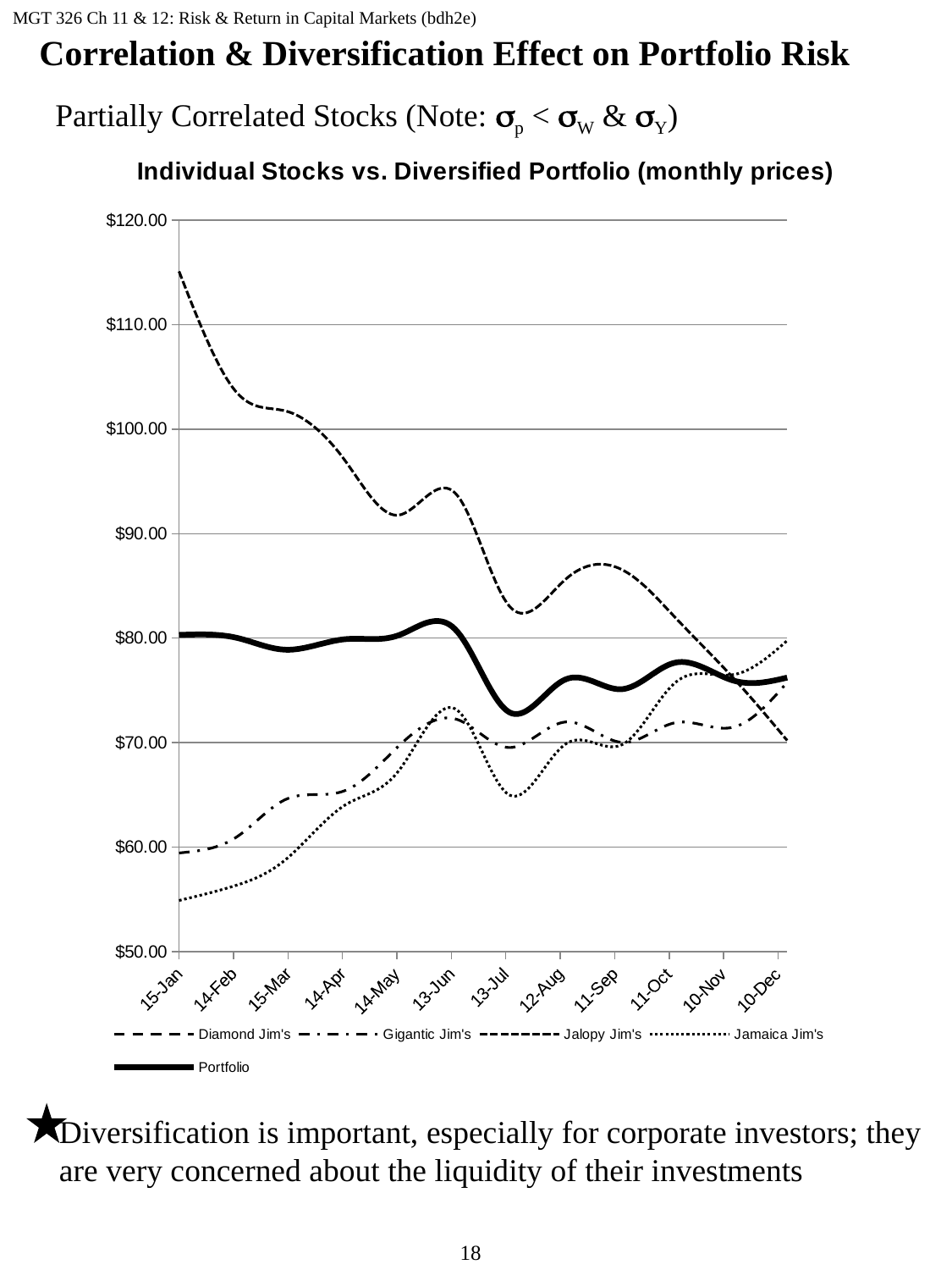
Does the Jamaica Jim's line rise or fall overall from 15-Jan to 10-Dec? rise Which series has the lowest value at 15-Jan? Jamaica Jim's Is the value for Portfolio at 15-Jan greater or less than $90.00? less How many dates are shown along the x axis of the chart? 12 What is the title of the chart? Individual Stocks vs. Diversified Portfolio (monthly prices) Is the value for Gigantic Jim's at 15-Mar greater or less than $60.00? greater How many series does the chart's legend list? 5 What is the lowest value labelled on the y axis of the chart? $50.00 At 15-Jan, which is higher: Portfolio or Jamaica Jim's? Portfolio What kind of chart is shown on the slide? line chart Is the value for Jamaica Jim's at 15-Jan greater or less than $60.00? less